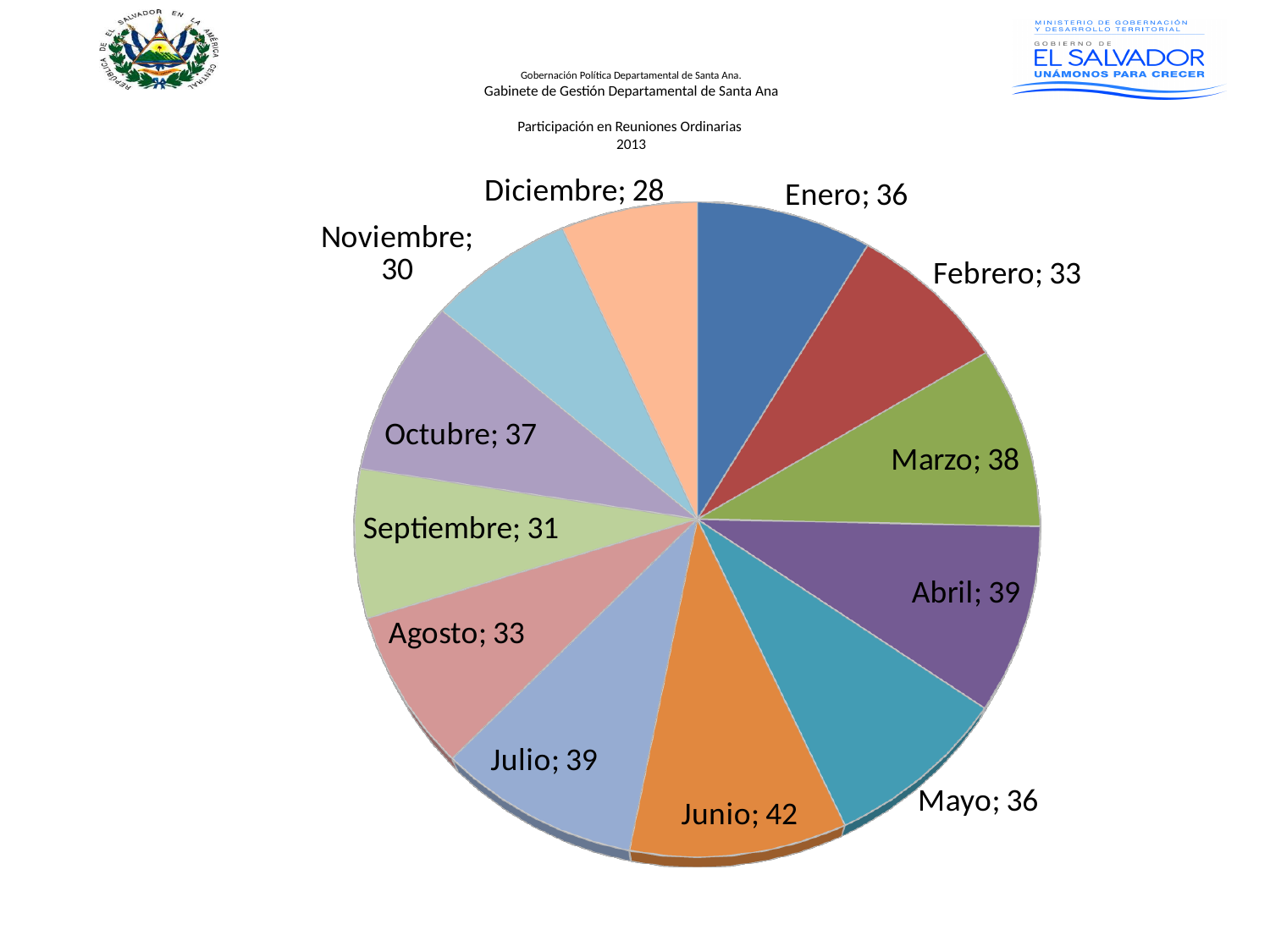
Which month has the lowest value? Diciembre What is the difference between the values for Abril and Febrero? 6 What is the value for Diciembre? 28 How many slices does the pie chart have? 12 What is the title of the chart? Participación en Reuniones Ordinarias 2013 Which month has the highest value? Junio What kind of chart is shown on the slide? Pie chart What is the value for Septiembre? 31 What is the value for Junio? 42 What is the value for Octubre? 37 What is the difference between the values for Junio and Diciembre? 14 Which is larger, the value for Marzo or the value for Noviembre? Marzo